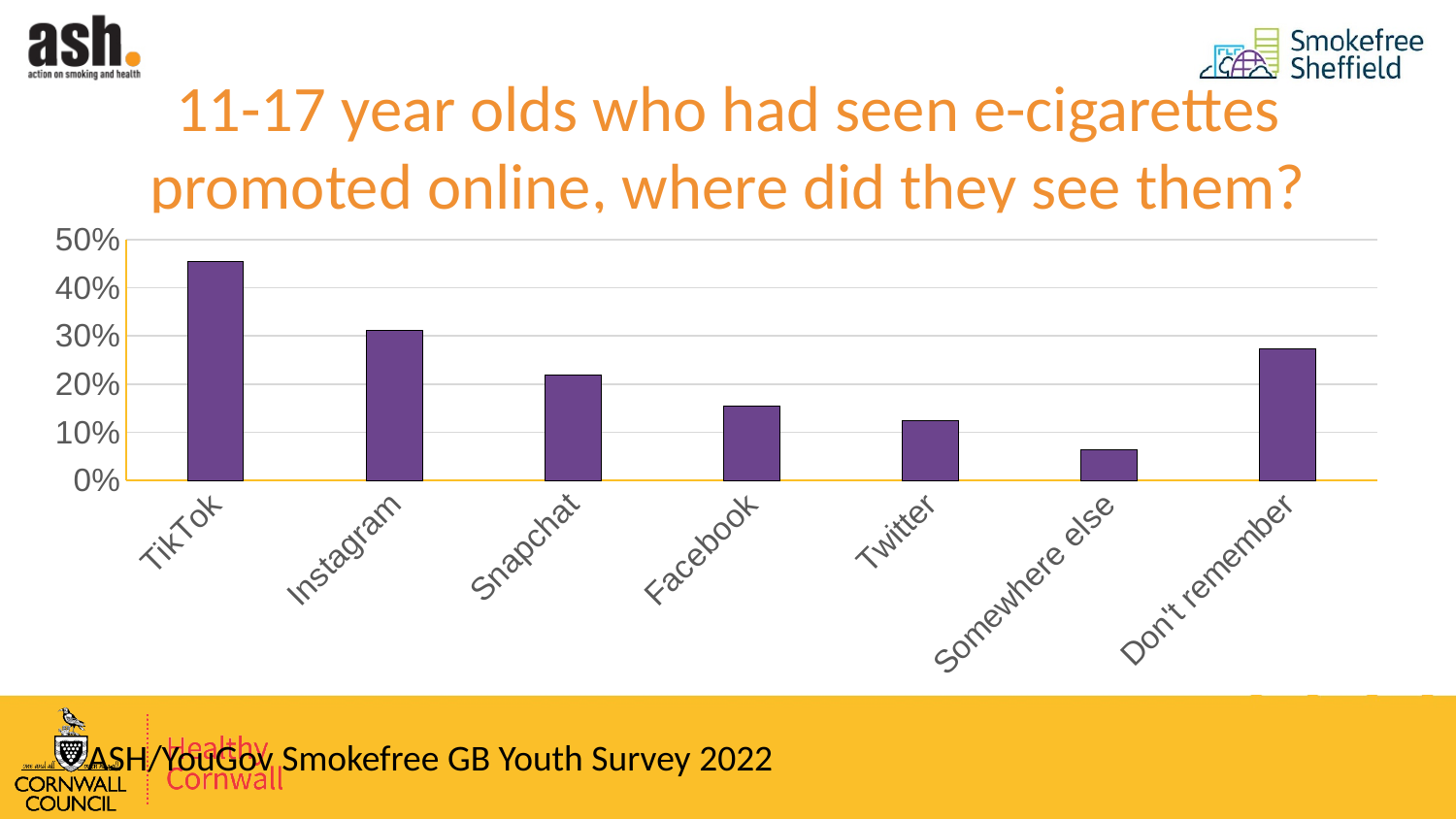
Which is larger, the value for Snapchat or the value for Don't remember? Don't remember Which category has the highest value in the chart? TikTok Which is larger, the value for Instagram or the value for Facebook? Instagram Which category has the lowest value in the chart? Somewhere else Is the value for Facebook greater or less than 10%? greater Is the value for Somewhere else greater or less than 10%? less Is the value for TikTok greater or less than 40%? greater What is the title of the chart on the slide? 11-17 year olds who had seen e-cigarettes promoted online, where did they see them? How many categories are shown on the x axis of the chart? 7 What type of chart is shown on the slide? bar chart